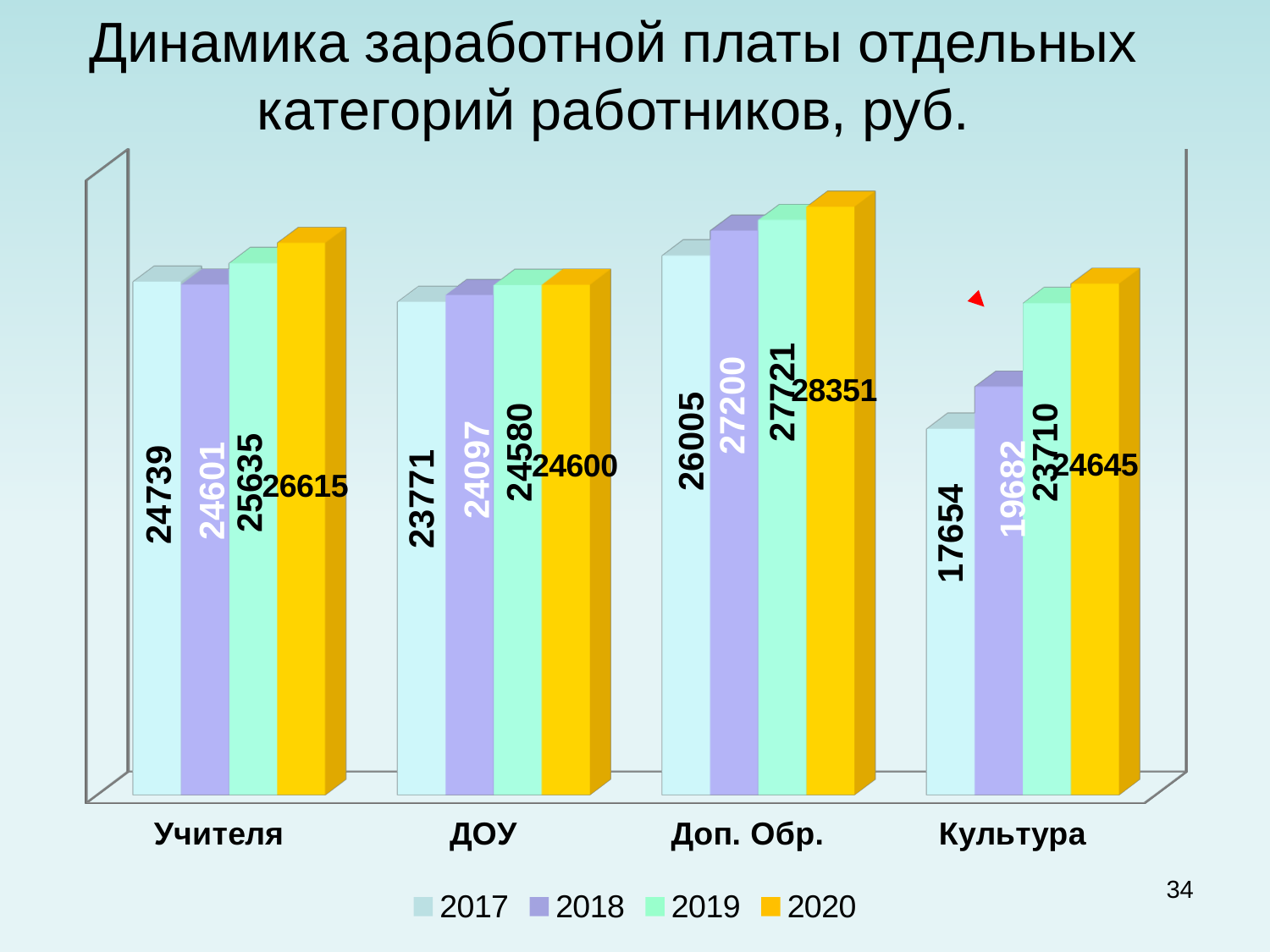
What kind of chart is shown on the slide? bar chart What was the salary for Культура in 2017? 17654 Which is larger: the 2018 salary for Учителя or the 2018 salary for ДОУ? Учителя What is the difference between the 2020 and 2017 salary for Культура? 6991 Do the salaries for Культура rise or fall from 2017 to 2020? rise What was the salary for Доп. Обр. in 2018? 27200 Which category had the lowest salary in 2017? Культура What was the salary for Учителя in 2020? 26615 What was the salary for ДОУ in 2019? 24580 Which category had the highest salary in 2020? Доп. Обр. How many categories of workers are shown on the x axis? 4 How many series does the legend list? 4